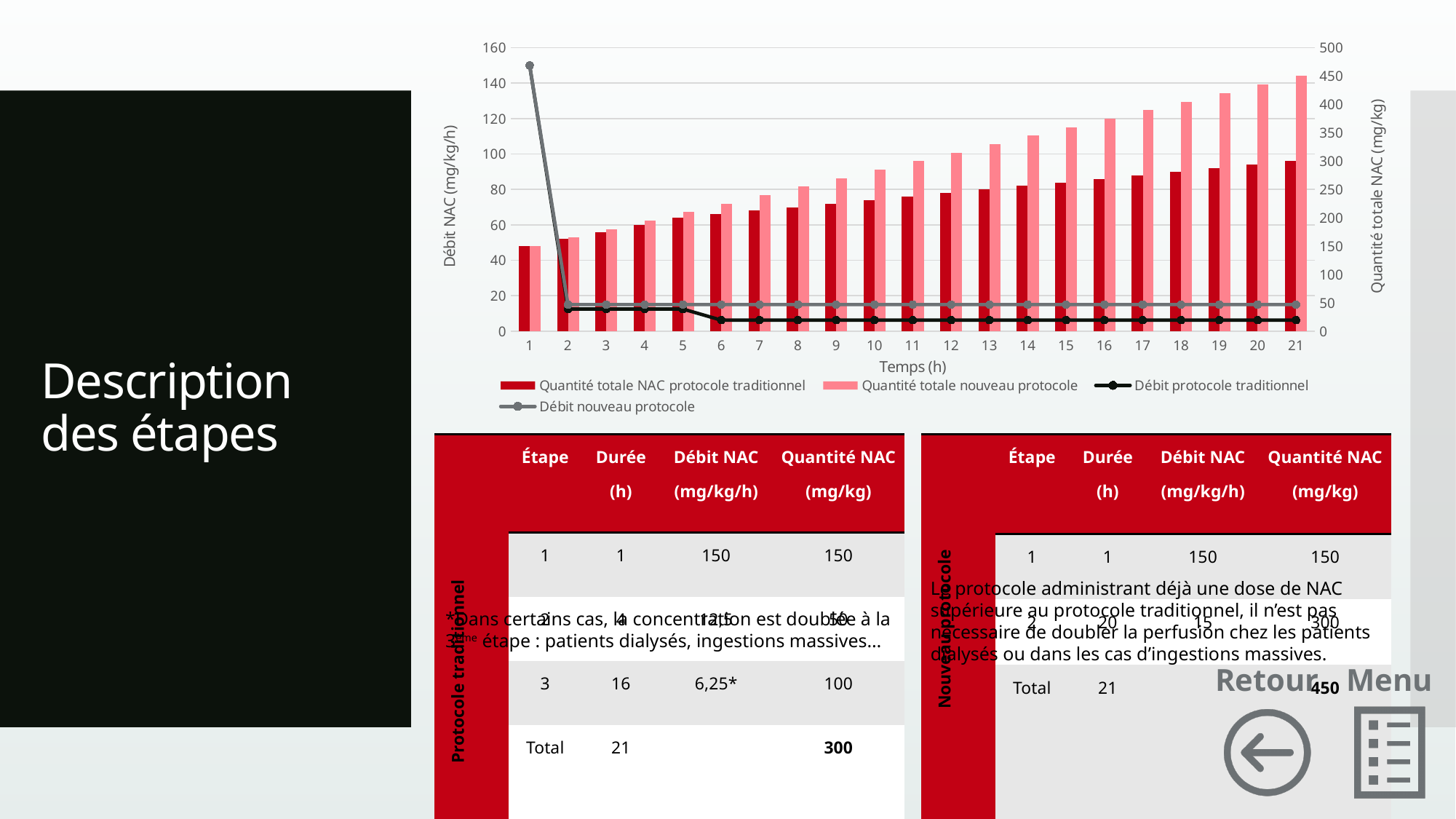
Is the value of Débit protocole traditionnel at time 10 greater or less than 20 on the left axis? less Is the value of Débit nouveau protocole at time 1 greater or less than 140 on the left axis? greater How many time points are shown on the x axis of the chart? 21 Do the bars for Quantité totale nouveau protocole rise or fall as time increases along the x axis? Rise What is the title of the left y axis of the chart? Débit NAC (mg/kg/h) What kind of chart is shown on the slide? Combination bar and line chart At time 21, which is larger: Quantité totale nouveau protocole or Quantité totale NAC protocole traditionnel? Quantité totale nouveau protocole At which time point is the bar for Quantité totale nouveau protocole highest? 21 Is the value of Quantité totale nouveau protocole at time 21 greater or less than 400 on the right axis? greater What is the title of the x axis of the chart? Temps (h) How many series does the chart legend list? 4 At which time point is the bar for Quantité totale NAC protocole traditionnel lowest? 1